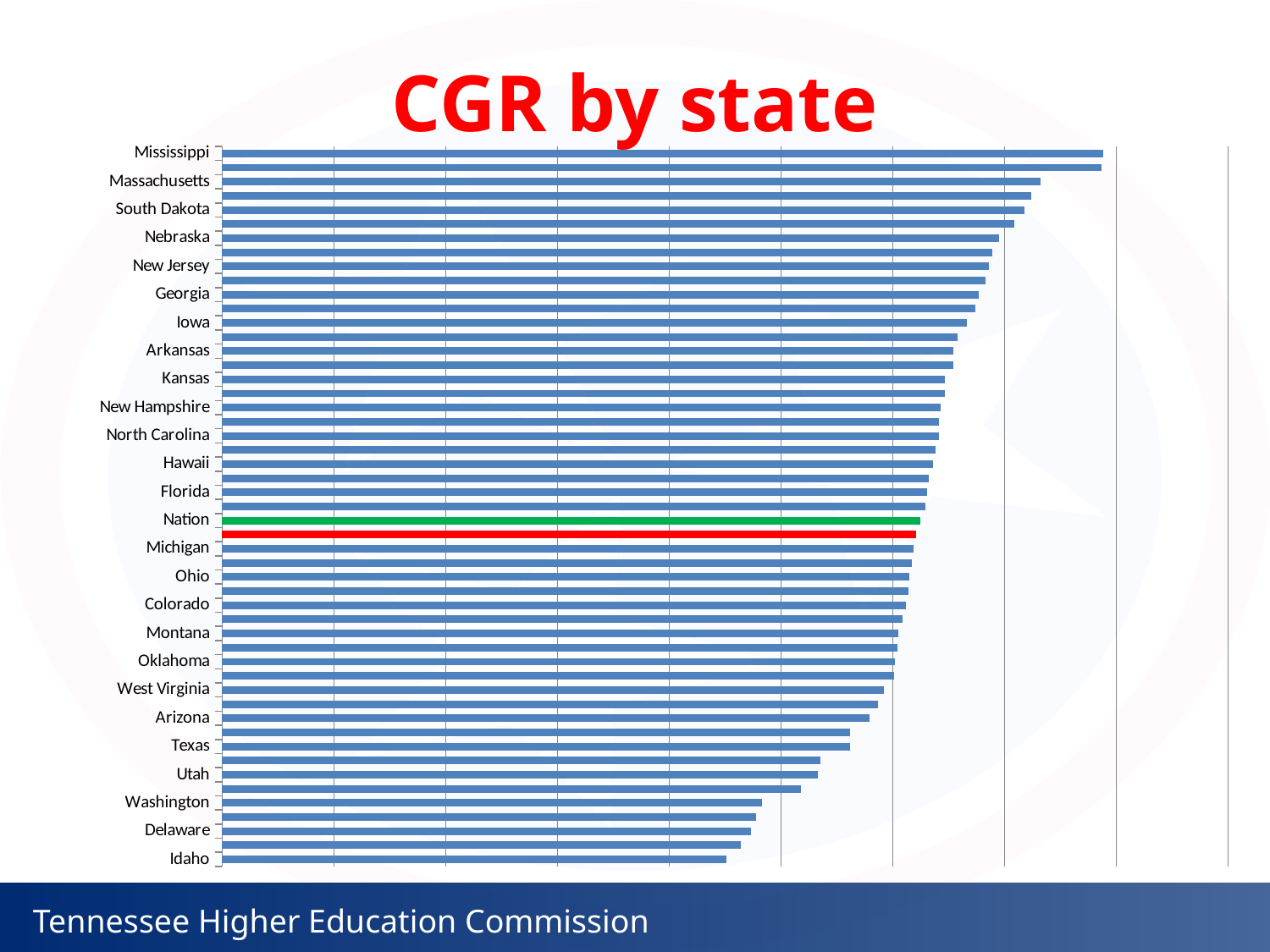
Which labeled state has the shortest bar in the chart? Idaho What colour is the bar for Nation? green Which has the larger value, Massachusetts or Texas? Massachusetts What kind of chart is shown on the slide? bar chart Which has the larger value, Mississippi or Idaho? Mississippi Which has the larger value, Washington or Kansas? Kansas What is the title of the chart? CGR by state Do the bar values rise or fall going from the top of the chart (Mississippi) to the bottom (Idaho)? fall Which labeled state has the longest bar in the chart? Mississippi